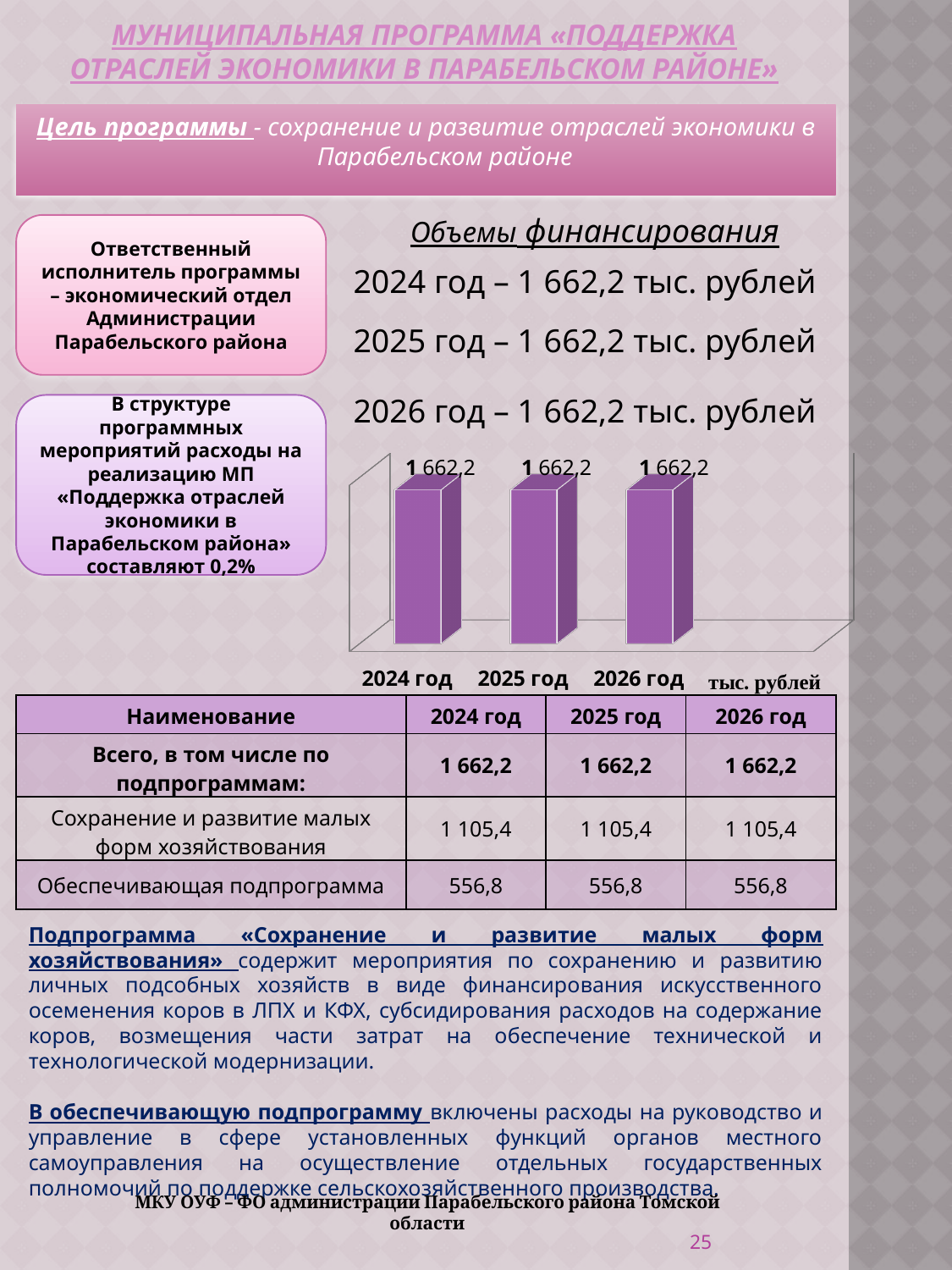
How many bars (categories) are plotted in the chart? 3 What is the value shown for 2024 год in the bar chart? 1 662,2 What is the value shown for 2026 год in the bar chart? 1 662,2 What is the value shown for 2025 год in the bar chart? 1 662,2 What unit is indicated for the values in the chart? тыс. рублей What kind of chart is shown on the slide? bar chart Is the value for 2024 год larger than, smaller than, or equal to the value for 2026 год? equal What is the difference between the values for 2025 год and 2024 год in the chart? 0 Which category labels appear along the bottom of the chart? 2024 год, 2025 год, 2026 год Do the values in the chart rise, fall, or stay the same from 2024 год to 2026 год? stay the same